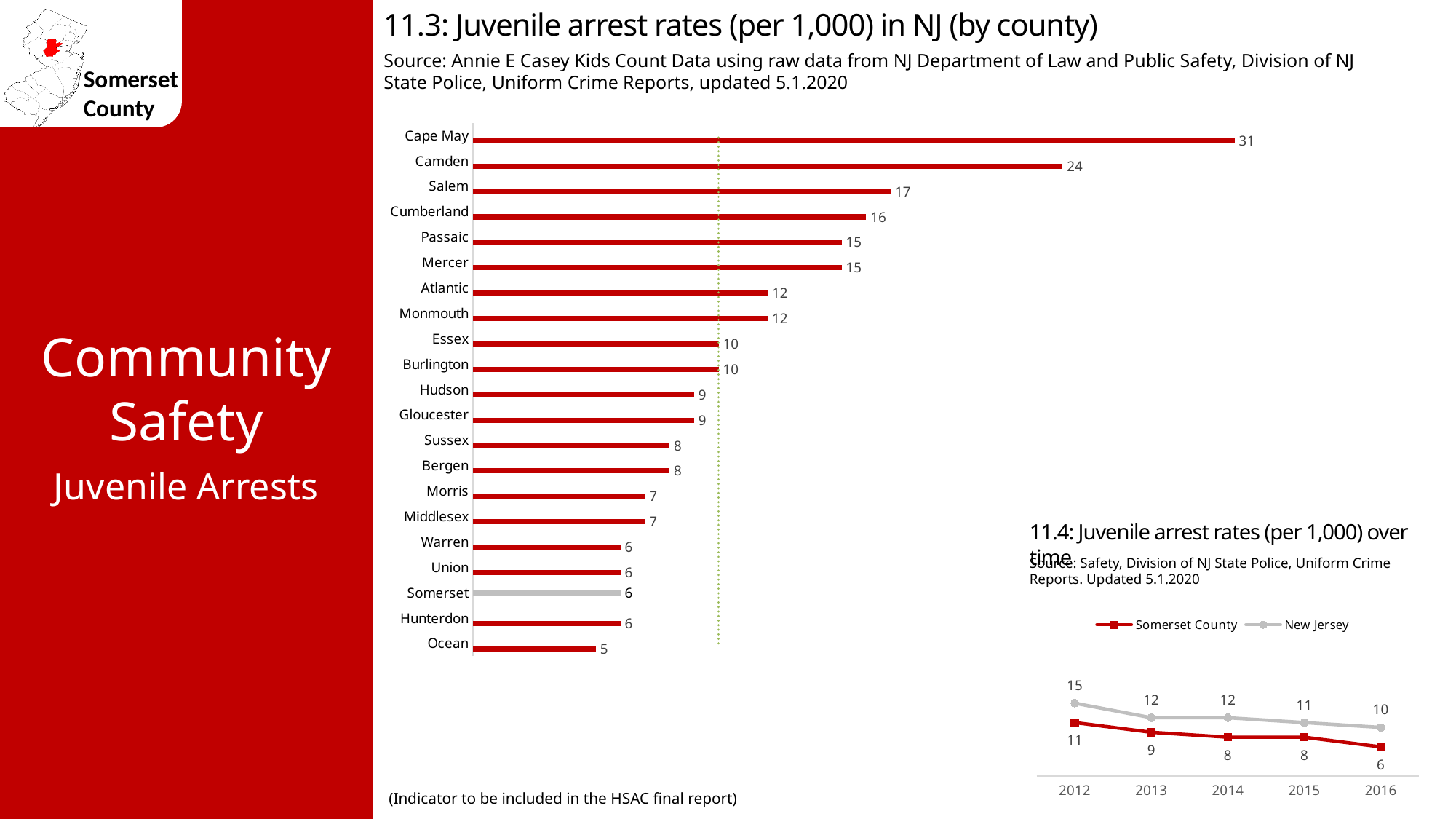
In the chart '11.3: Juvenile arrest rates (per 1,000) in NJ (by county)', which is larger, the value for Cumberland or the value for Atlantic? Cumberland What kind of chart is '11.3: Juvenile arrest rates (per 1,000) in NJ (by county)'? Bar chart In the chart '11.3: Juvenile arrest rates (per 1,000) in NJ (by county)', what is the value for Cape May? 31 In the chart '11.3: Juvenile arrest rates (per 1,000) in NJ (by county)', what is the value for Somerset? 6 In the chart '11.4: Juvenile arrest rates (per 1,000) over time', how many series does the legend list? 2 In the chart '11.3: Juvenile arrest rates (per 1,000) in NJ (by county)', which county has the lowest value? Ocean In the chart '11.3: Juvenile arrest rates (per 1,000) in NJ (by county)', how many counties are shown? 21 In the chart '11.4: Juvenile arrest rates (per 1,000) over time', do the Somerset County values rise or fall from 2012 to 2016? Fall In the chart '11.4: Juvenile arrest rates (per 1,000) over time', what is the value for New Jersey in 2012? 15 In the chart '11.3: Juvenile arrest rates (per 1,000) in NJ (by county)', which county has the highest value? Cape May In the chart '11.4: Juvenile arrest rates (per 1,000) over time', what is the value for Somerset County in 2013? 9 In the chart '11.3: Juvenile arrest rates (per 1,000) in NJ (by county)', what is the difference between the values for Camden and Salem? 7